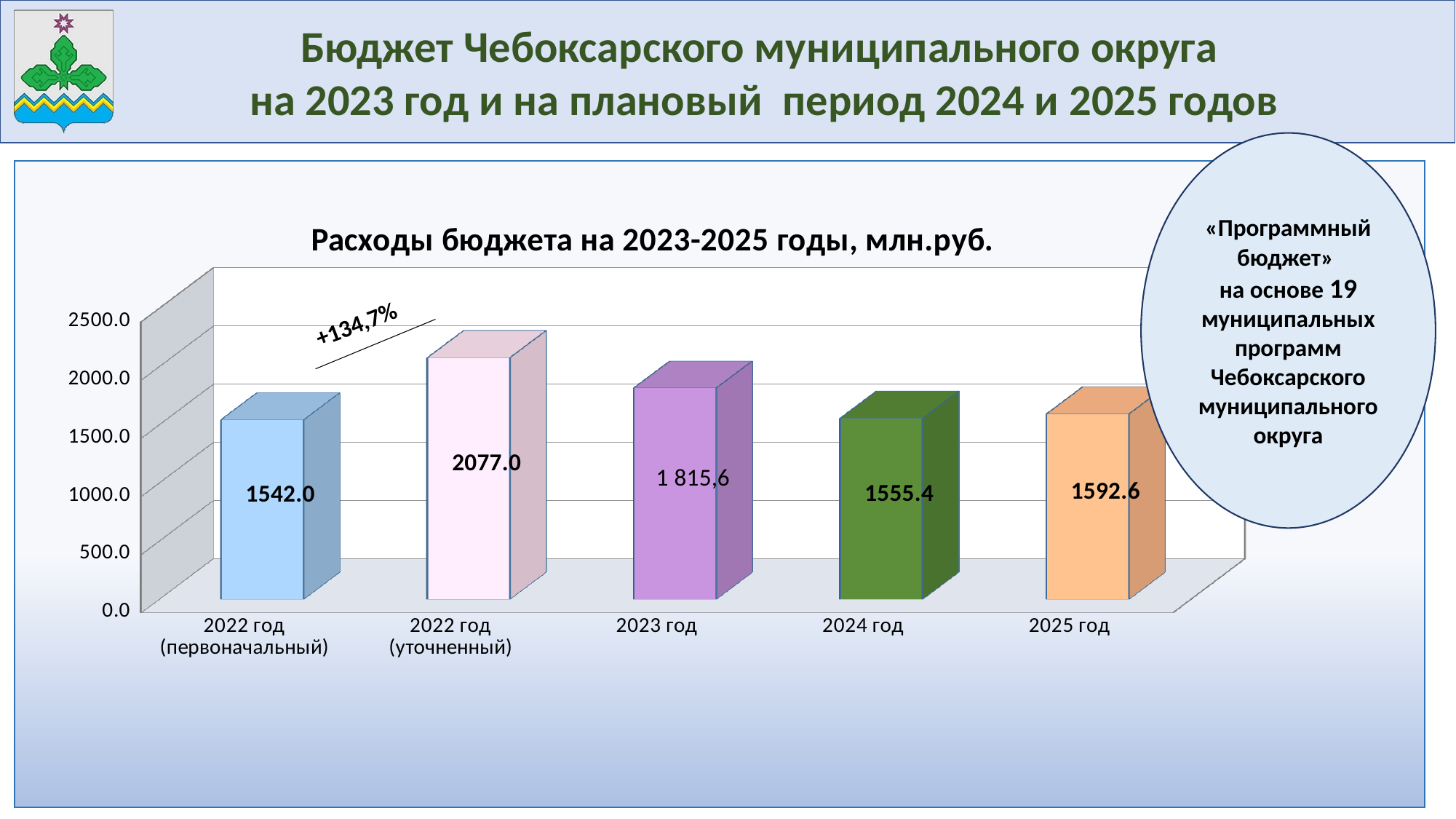
What is the value for 2024 год? 1555.4 How many categories are shown on the x axis? 5 What is the value for 2022 год (уточненный)? 2077.0 What is the value for 2022 год (первоначальный)? 1542.0 What is the title of the chart? Расходы бюджета на 2023-2025 годы, млн.руб. What kind of chart is this? Bar chart What is the value for 2023 год? 1 815,6 What is the difference between the values for 2022 год (уточненный) and 2022 год (первоначальный)? 535.0 Which category has the lowest value? 2022 год (первоначальный) What is the value for 2025 год? 1592.6 Which category has the highest value? 2022 год (уточненный) Which is larger, the value for 2024 год or the value for 2025 год? 2025 год